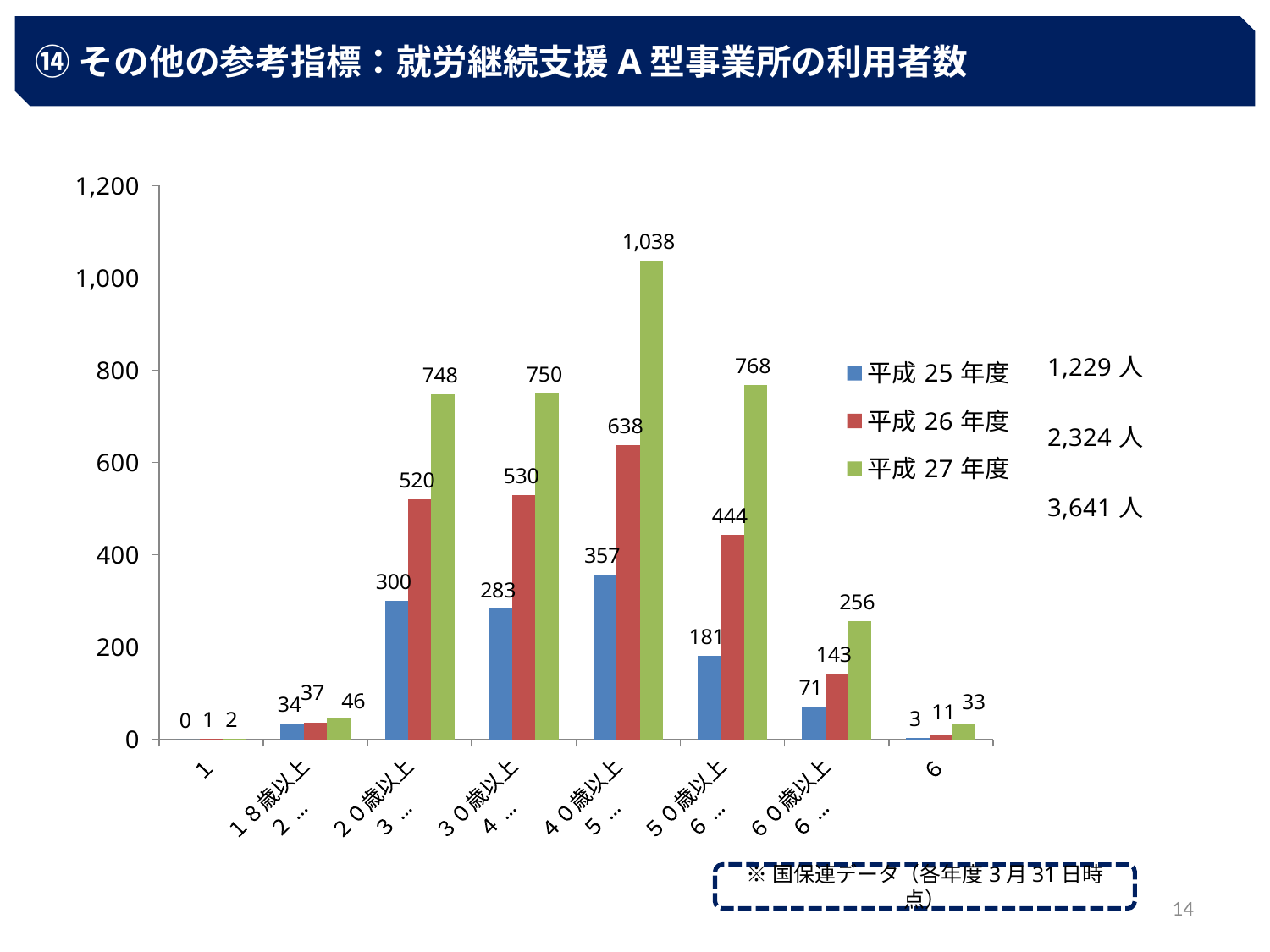
Is the 平成27年度 value for 50歳以上 greater or less than 600? greater Which series is shown in green in the legend? 平成27年度 What is the difference between the 平成27年度 and 平成26年度 values in the 50歳以上 category? 324 What is the value for 平成27年度 in the 40歳以上 category? 1,038 How many series does the legend list? 3 How many age categories are plotted along the x axis? 8 What is the value for 平成26年度 in the 60歳以上 category? 143 Which age category has the highest value for 平成27年度? 40歳以上 What is the value for 平成25年度 in the 20歳以上 category? 300 Which age category has the lowest value for 平成26年度? the first category (value 1) Which is larger: the 平成26年度 value for 20歳以上 or the 平成26年度 value for 30歳以上? 30歳以上 What type of chart is shown on the slide? bar chart